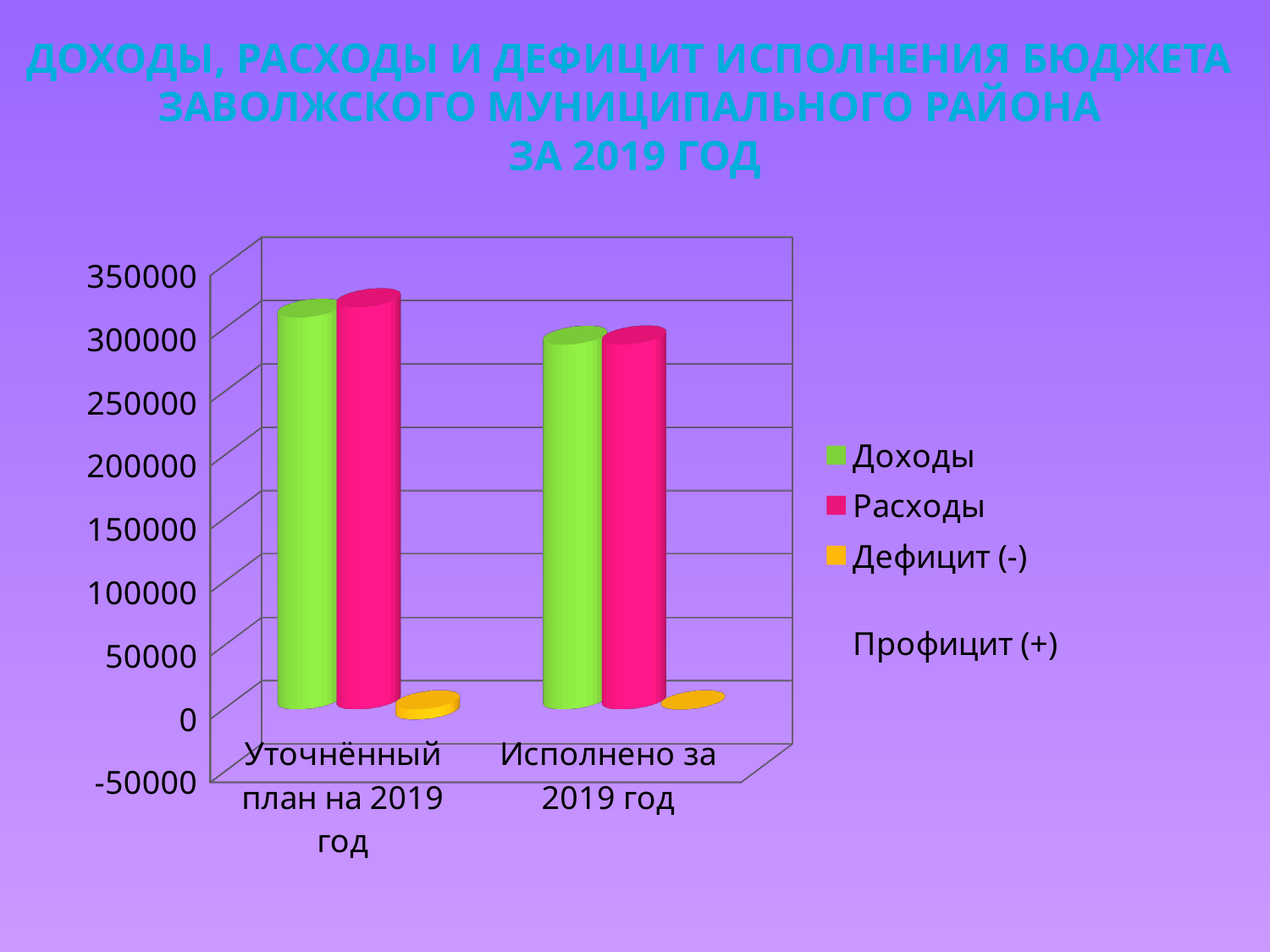
Is the value of Доходы for Уточнённый план на 2019 год greater or less than 300000? greater Is the value of Доходы for Исполнено за 2019 год greater or less than 250000? greater Is the value of Дефицит (-) Профицит (+) for Исполнено за 2019 год greater or less than 50000? less Do the Расходы values rise or fall from Уточнённый план на 2019 год to Исполнено за 2019 год? fall What colour are the Доходы bars in the chart? green How many series does the chart's legend list? 3 What kind of chart is shown on the slide? bar chart How many categories are shown on the x axis of the chart? 2 Which is larger: Доходы for Уточнённый план на 2019 год or Доходы for Исполнено за 2019 год? Уточнённый план на 2019 год Which is larger: Расходы for Уточнённый план на 2019 год or Расходы for Исполнено за 2019 год? Уточнённый план на 2019 год